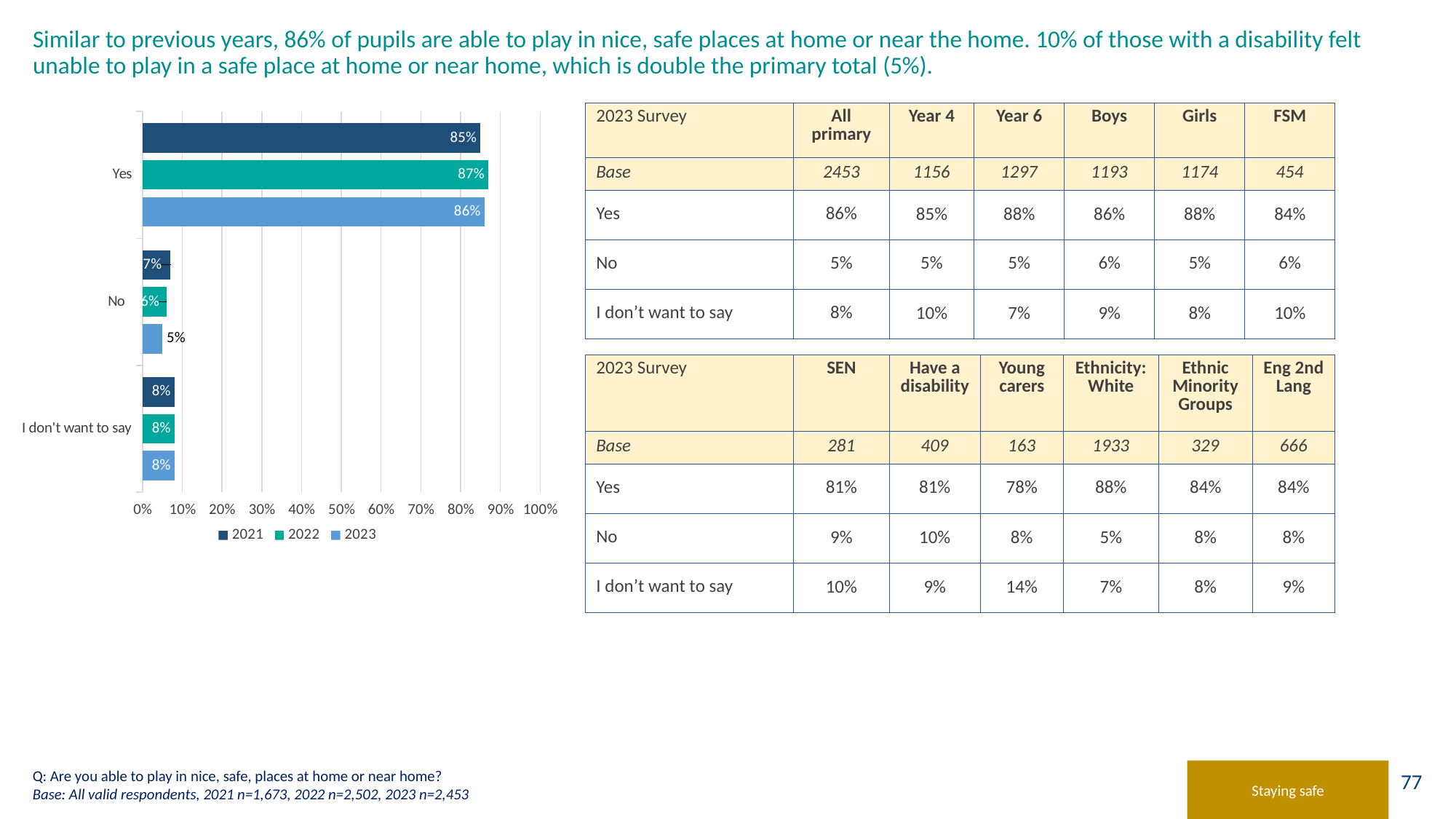
What is the value for 'I don't want to say' in the 2021 series? 8% Which year has the lowest value for 'No'? 2023 What is the value for 'Yes' in the 2021 series? 85% Which year has the highest value for 'Yes'? 2022 What kind of chart is shown on the slide? bar chart How many categories are shown on the chart? 3 Is the 2021 value for 'No' larger or smaller than the 2023 value for 'No'? larger What is the value for 'Yes' in the 2022 series? 87% What is the difference between the 2022 and 2021 values for 'Yes'? 2% What is the value for 'No' in the 2023 series? 5% How many series does the legend list? 3 Which series is shown in light blue in the legend? 2023